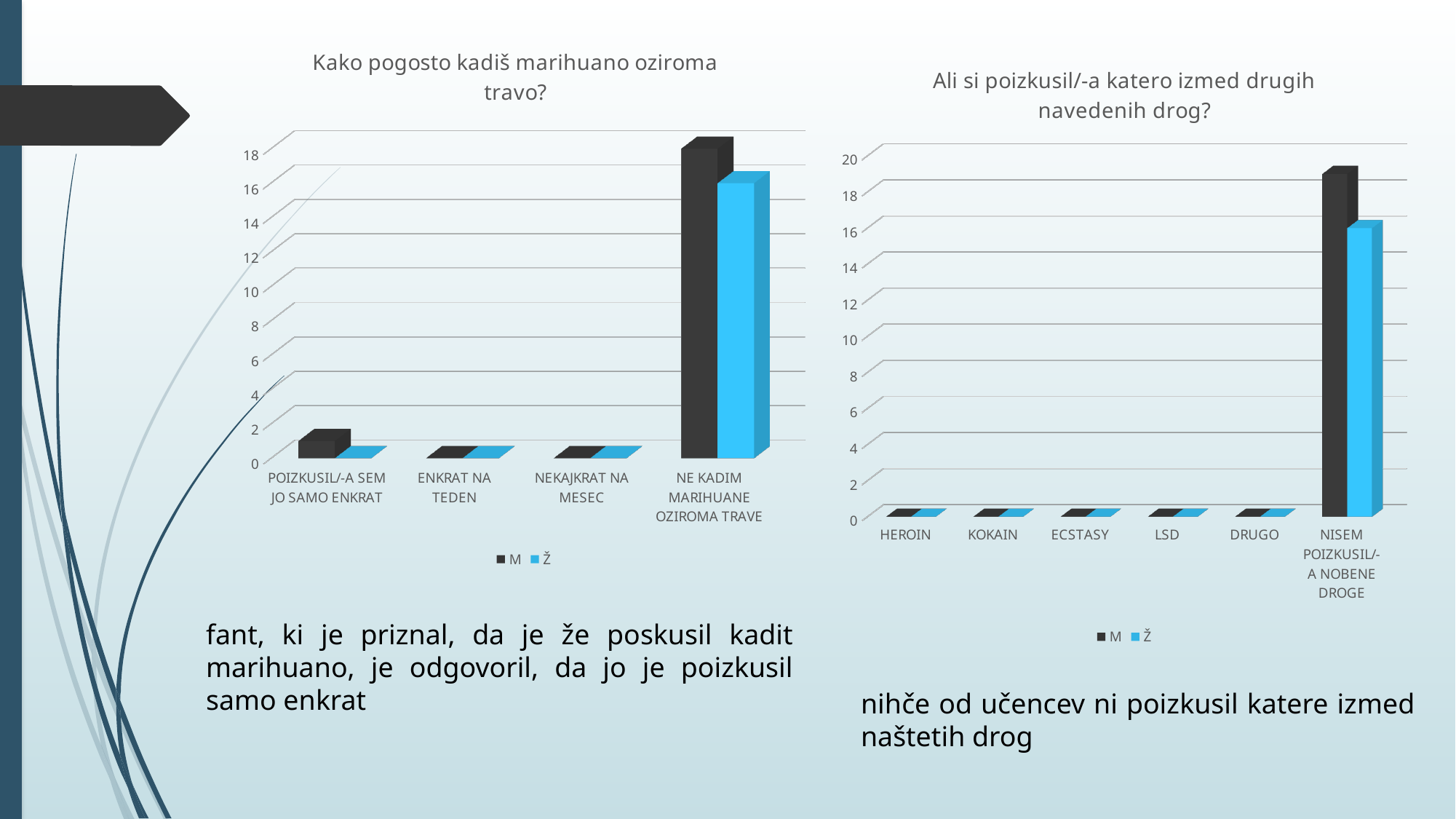
In the right chart "Ali si poizkusil/-a katero izmed drugih navedenih drog?", which category has the highest value for series Ž? NISEM POIZKUSIL/-A NOBENE DROGE What colour are the bars for series Ž in the right chart "Ali si poizkusil/-a katero izmed drugih navedenih drog?"? light blue How many categories are shown on the x axis of the right chart "Ali si poizkusil/-a katero izmed drugih navedenih drog?"? 6 In the right chart "Ali si poizkusil/-a katero izmed drugih navedenih drog?", is the value of Ž for NISEM POIZKUSIL/-A NOBENE DROGE greater or less than 18? less In the left chart "Kako pogosto kadiš marihuano oziroma travo?", is the value of M for POIZKUSIL/-A SEM JO SAMO ENKRAT greater or less than 2? less How many categories are shown on the x axis of the left chart "Kako pogosto kadiš marihuano oziroma travo?"? 4 In the left chart "Kako pogosto kadiš marihuano oziroma travo?", which category has the highest value for series M? NE KADIM MARIHUANE OZIROMA TRAVE In the left chart "Kako pogosto kadiš marihuano oziroma travo?", which is larger for NE KADIM MARIHUANE OZIROMA TRAVE, M or Ž? M In the left chart "Kako pogosto kadiš marihuano oziroma travo?", is the value of M for NE KADIM MARIHUANE OZIROMA TRAVE greater or less than 16? greater What kind of chart is the left chart titled "Kako pogosto kadiš marihuano oziroma travo?"? bar chart How many series does the legend of the right chart "Ali si poizkusil/-a katero izmed drugih navedenih drog?" list? 2